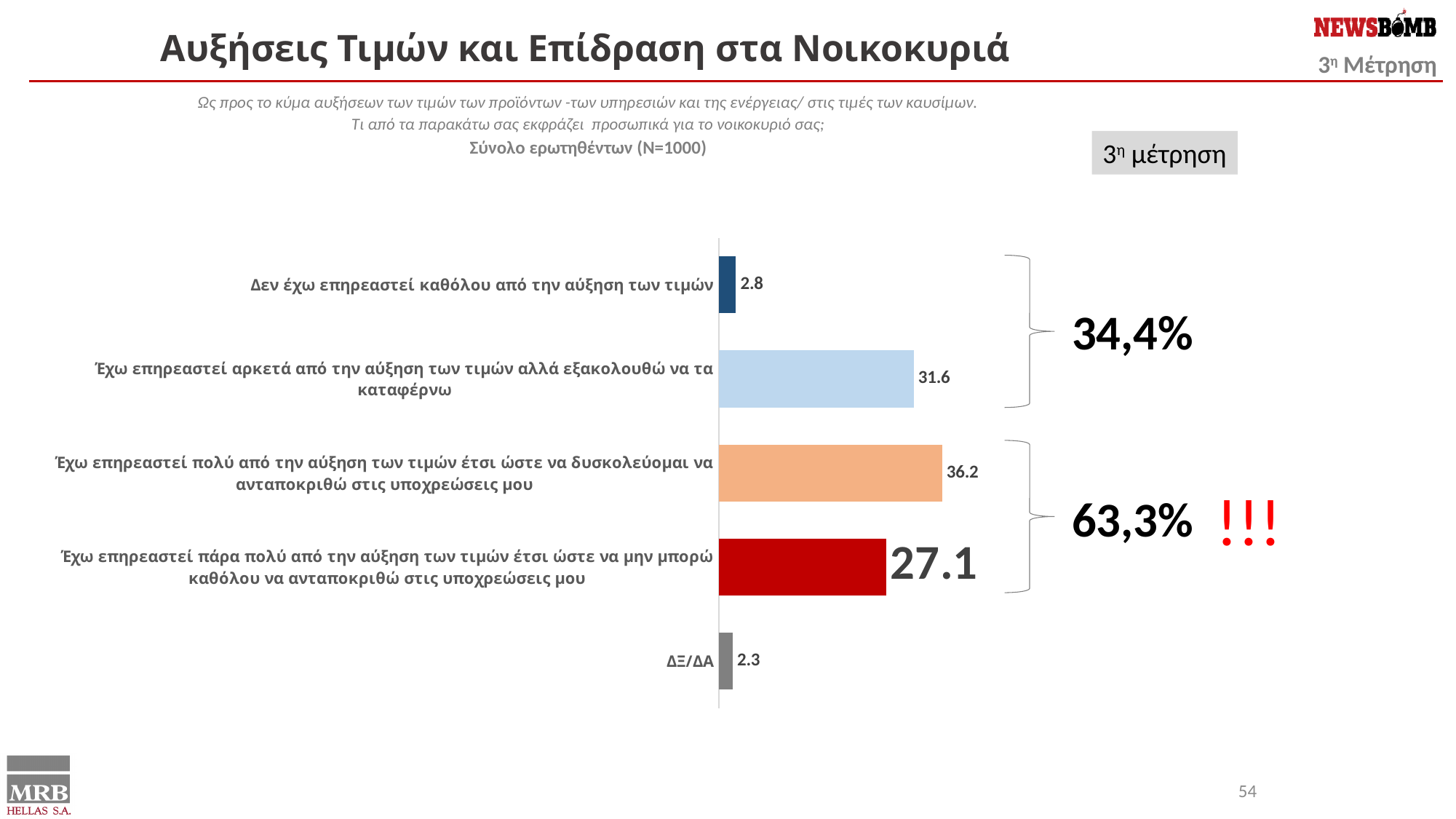
Which category has the lowest value? ΔΞ/ΔΑ What is the value for "Έχω επηρεαστεί πάρα πολύ από την αύξηση των τιμών έτσι ώστε να μην μπορώ καθόλου να ανταποκριθώ στις υποχρεώσεις μου"? 27.1 Which category has the highest value? Έχω επηρεαστεί πολύ από την αύξηση των τιμών έτσι ώστε να δυσκολεύομαι να ανταποκριθώ στις υποχρεώσεις μου What is the value for "Έχω επηρεαστεί αρκετά από την αύξηση των τιμών αλλά εξακολουθώ να τα καταφέρνω"? 31.6 What kind of chart is shown on the slide? Bar chart Which is larger: the value for "Έχω επηρεαστεί αρκετά..." or the value for "Έχω επηρεαστεί πάρα πολύ..."? Έχω επηρεαστεί αρκετά... What combined percentage is shown next to the bracket grouping the first two categories ("καθόλου" and "αρκετά")? 34,4% What is the difference between the value for "Έχω επηρεαστεί πολύ..." (36.2) and "Έχω επηρεαστεί αρκετά..." (31.6)? 4.6 How many categories (bars) does the chart show? 5 What is the value for "Δεν έχω επηρεαστεί καθόλου από την αύξηση των τιμών"? 2.8 What is the value for ΔΞ/ΔΑ? 2.3 What combined percentage is shown next to the bracket grouping the two bottom-most affected categories ("πολύ" and "πάρα πολύ")? 63,3%